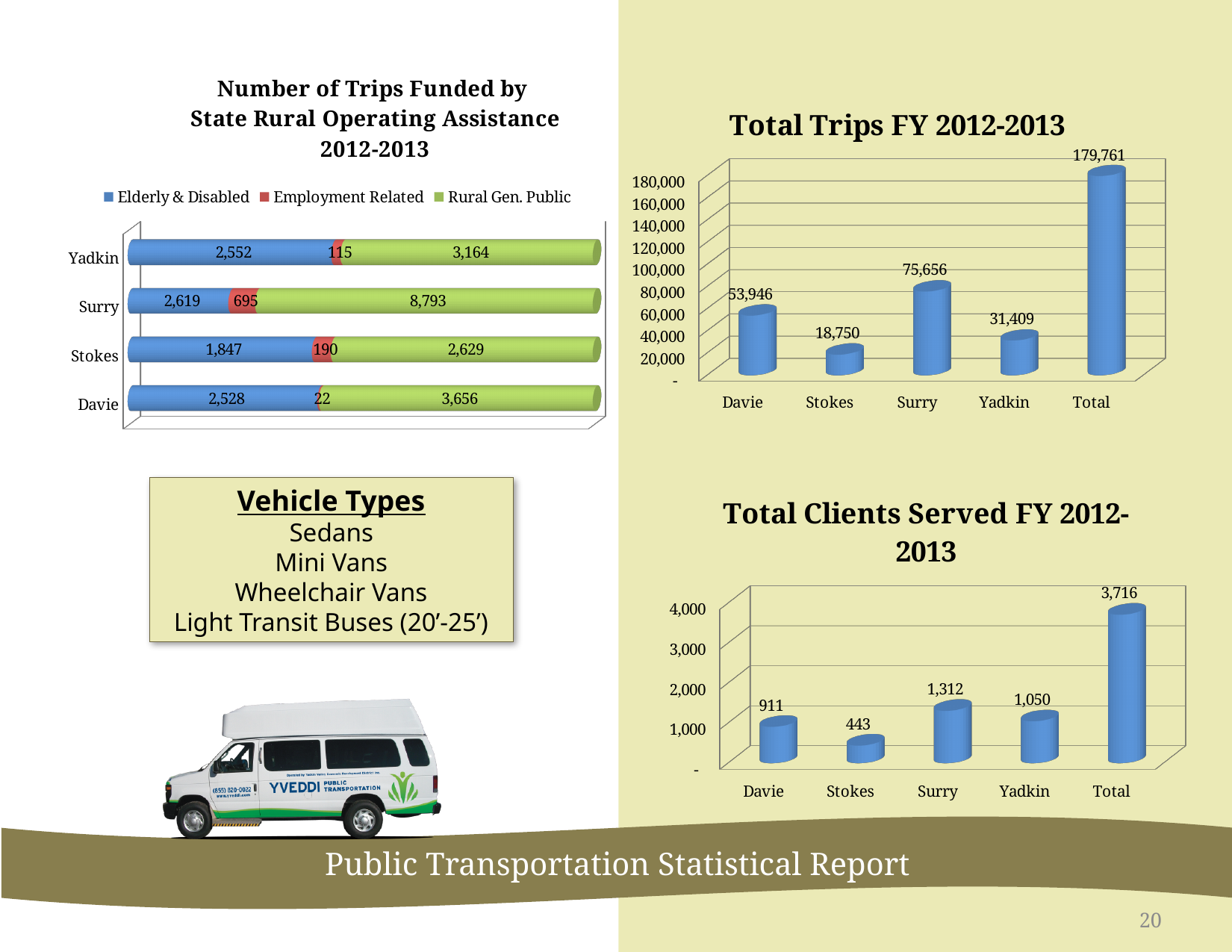
In the 'Total Clients Served FY 2012-2013' chart, which county has the lowest value? Stokes What kind of chart is the 'Number of Trips Funded by State Rural Operating Assistance 2012-2013' chart? Stacked bar chart In the 'Total Trips FY 2012-2013' chart, what is the difference between Surry and Davie? 21,710 How many categories are shown on the x axis of the 'Total Trips FY 2012-2013' chart? 5 How many series does the legend of the 'Number of Trips Funded by State Rural Operating Assistance 2012-2013' chart list? 3 In the 'Number of Trips Funded by State Rural Operating Assistance 2012-2013' chart, what is the Rural Gen. Public value for Surry? 8,793 In the 'Total Clients Served FY 2012-2013' chart, is the value for Davie larger or smaller than the value for Yadkin? Smaller In the 'Total Trips FY 2012-2013' chart, what is the value for Stokes? 18,750 In the 'Total Clients Served FY 2012-2013' chart, what is the value for Yadkin? 1,050 In the 'Number of Trips Funded by State Rural Operating Assistance 2012-2013' chart, what is the total of the stacked bar for Surry? 12,107 In the 'Number of Trips Funded by State Rural Operating Assistance 2012-2013' chart, what is the Employment Related value for Davie? 22 In the 'Total Trips FY 2012-2013' chart, which county has the highest number of trips (excluding Total)? Surry